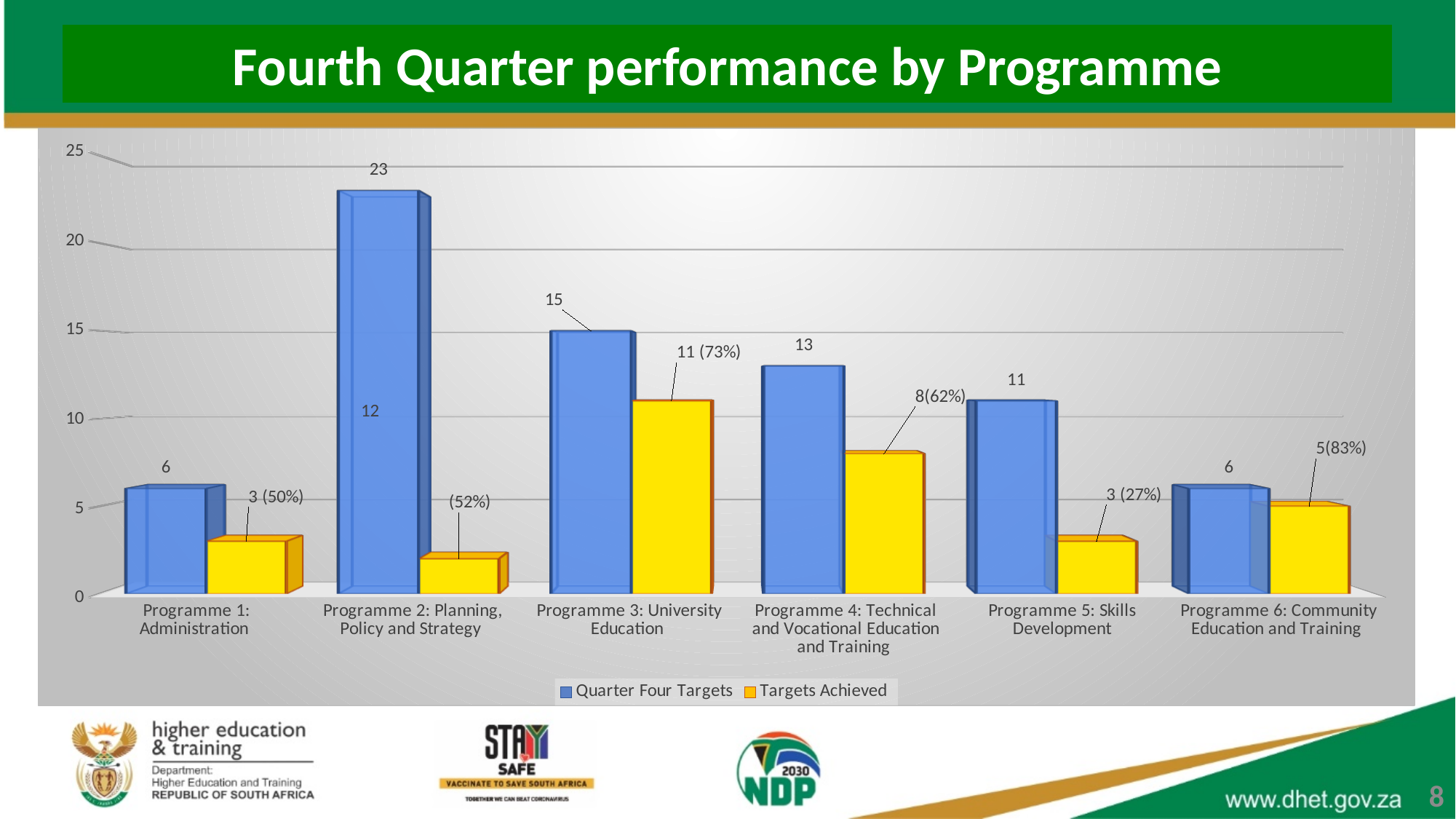
What is the difference between the Quarter Four Targets and Targets Achieved for Programme 5: Skills Development? 8 How many series does the legend list? 2 What is the Targets Achieved value for Programme 6: Community Education and Training? 5(83%) What kind of chart is shown on the slide? bar chart What is the Quarter Four Targets value for Programme 1: Administration? 6 What is the Targets Achieved value for Programme 4: Technical and Vocational Education and Training? 8(62%) Is the Quarter Four Targets value for Programme 2: Planning, Policy and Strategy greater or less than 20? greater Which programme has the highest Quarter Four Targets value? Programme 2: Planning, Policy and Strategy What is the difference between the Quarter Four Targets and Targets Achieved for Programme 3: University Education? 4 How many programmes are shown on the x axis? 6 Which is larger: the Quarter Four Targets for Programme 4 or for Programme 5? Programme 4 What is the Quarter Four Targets value for Programme 3: University Education? 15